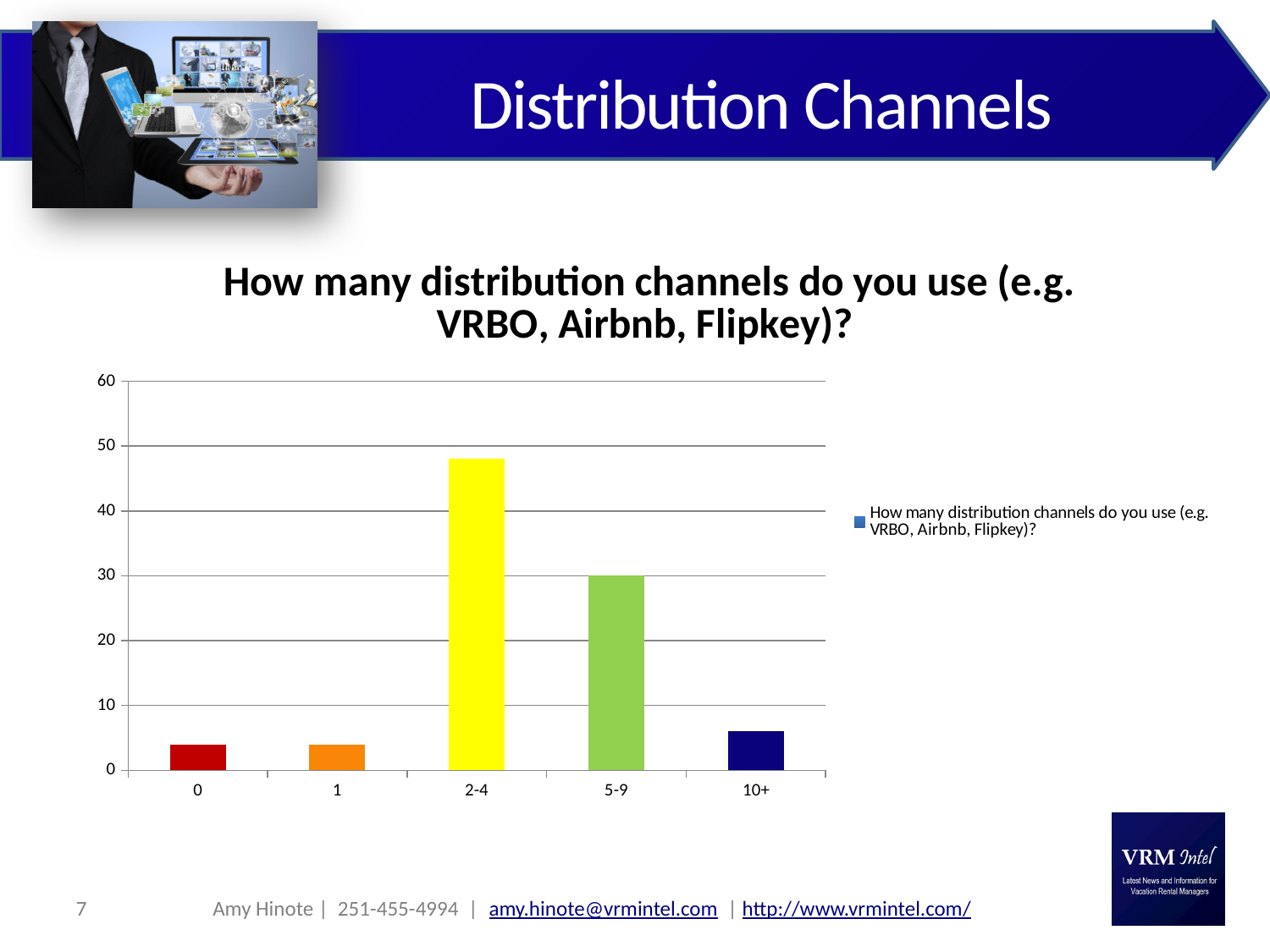
Which is larger, the value for 2-4 or the value for 5-9? 2-4 How many categories are shown on the x axis of the chart? 5 What is the value for the 5-9 category? 30 Is the value for the 1 category greater or less than 10? less What kind of chart is shown on the slide? bar chart Is the value for the 10+ category greater or less than 10? less How many series does the chart's legend list? 1 Is the value for the 2-4 category greater or less than 40? greater Which is larger, the value for 5-9 or the value for 10+? 5-9 What is the title of the chart? How many distribution channels do you use (e.g. VRBO, Airbnb, Flipkey)? Which category has the highest value in the chart? 2-4